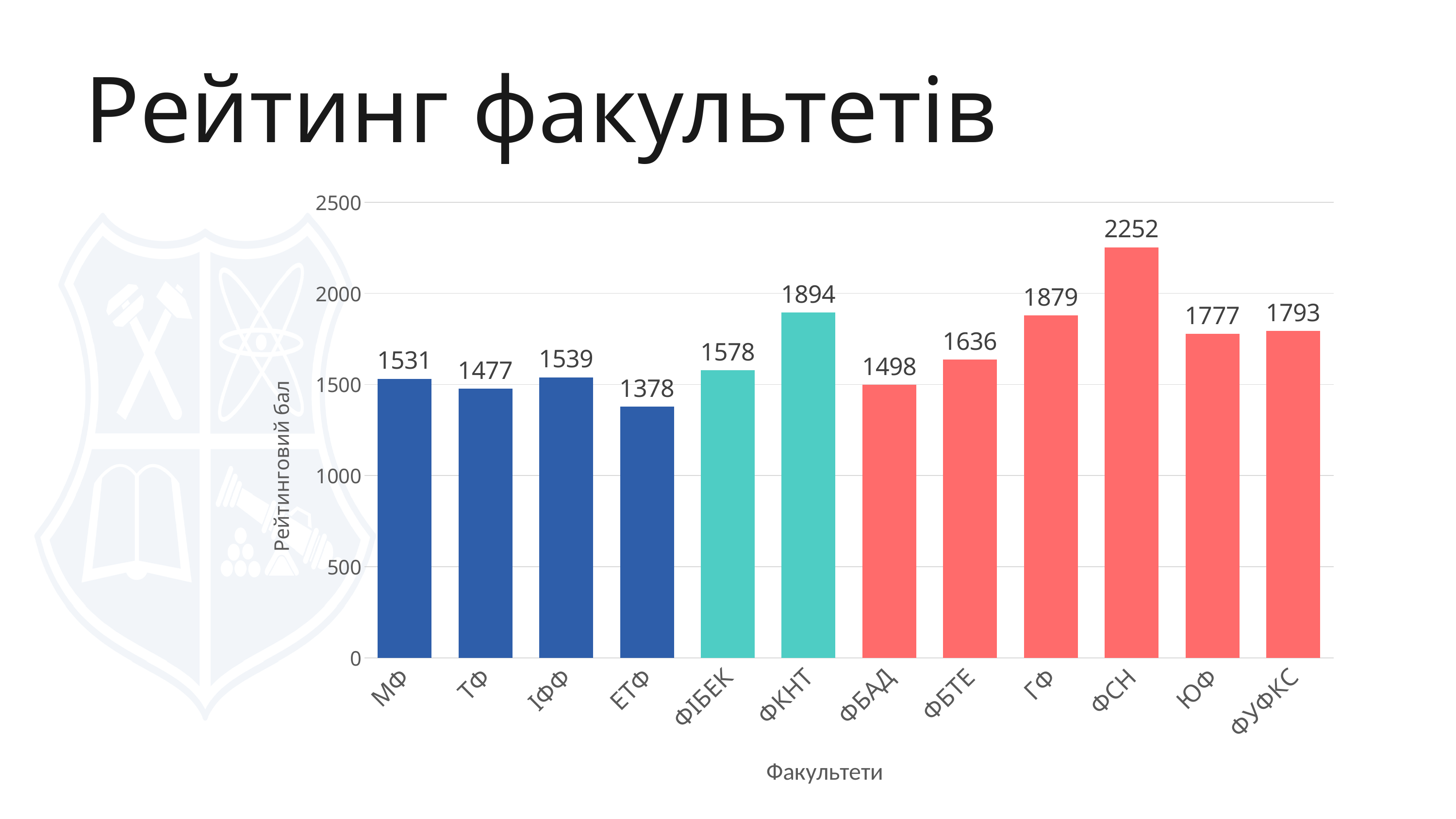
Which faculty has the highest rating score? ФСН What is the rating score for ЮФ? 1777 Is the value for ФСН greater or less than 2000? greater How many faculties are shown on the chart? 12 What is the difference between the rating scores of ФСН and ГФ? 373 What is the difference between the rating scores of ФБТЕ and ФБАД? 138 What kind of chart is shown on the slide? bar chart Which faculty has the lowest rating score? ЕТФ What is the rating score for ЕТФ? 1378 What is the rating score for ФКНТ? 1894 What is the label of the vertical axis? Рейтинговий бал Which has a higher rating score, ФУФКС or ЮФ? ФУФКС